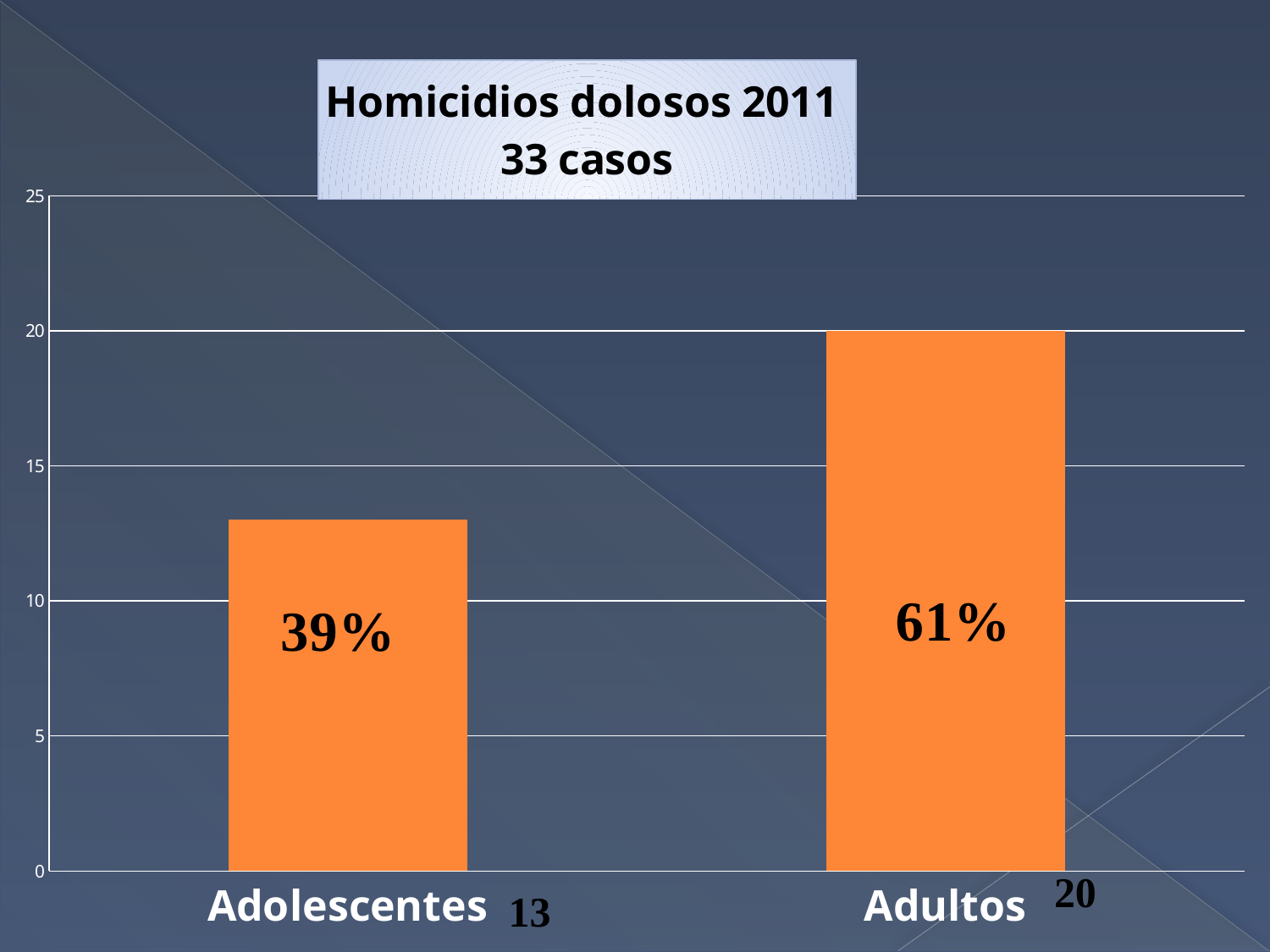
What kind of chart is shown on the slide? bar chart What is the difference between the number of cases for Adultos and Adolescentes? 7 What is the title of the chart? Homicidios dolosos 2011 33 casos What is the number of cases for Adultos? 20 Which category has the highest value? Adultos Which category has the lowest value? Adolescentes What is the number of cases for Adolescentes? 13 What percentage is shown on the Adultos bar? 61% Which is larger, the value for Adolescentes or the value for Adultos? Adultos How many categories are shown on the chart? 2 Is the value for Adolescentes greater or less than 15? less What percentage is shown on the Adolescentes bar? 39%